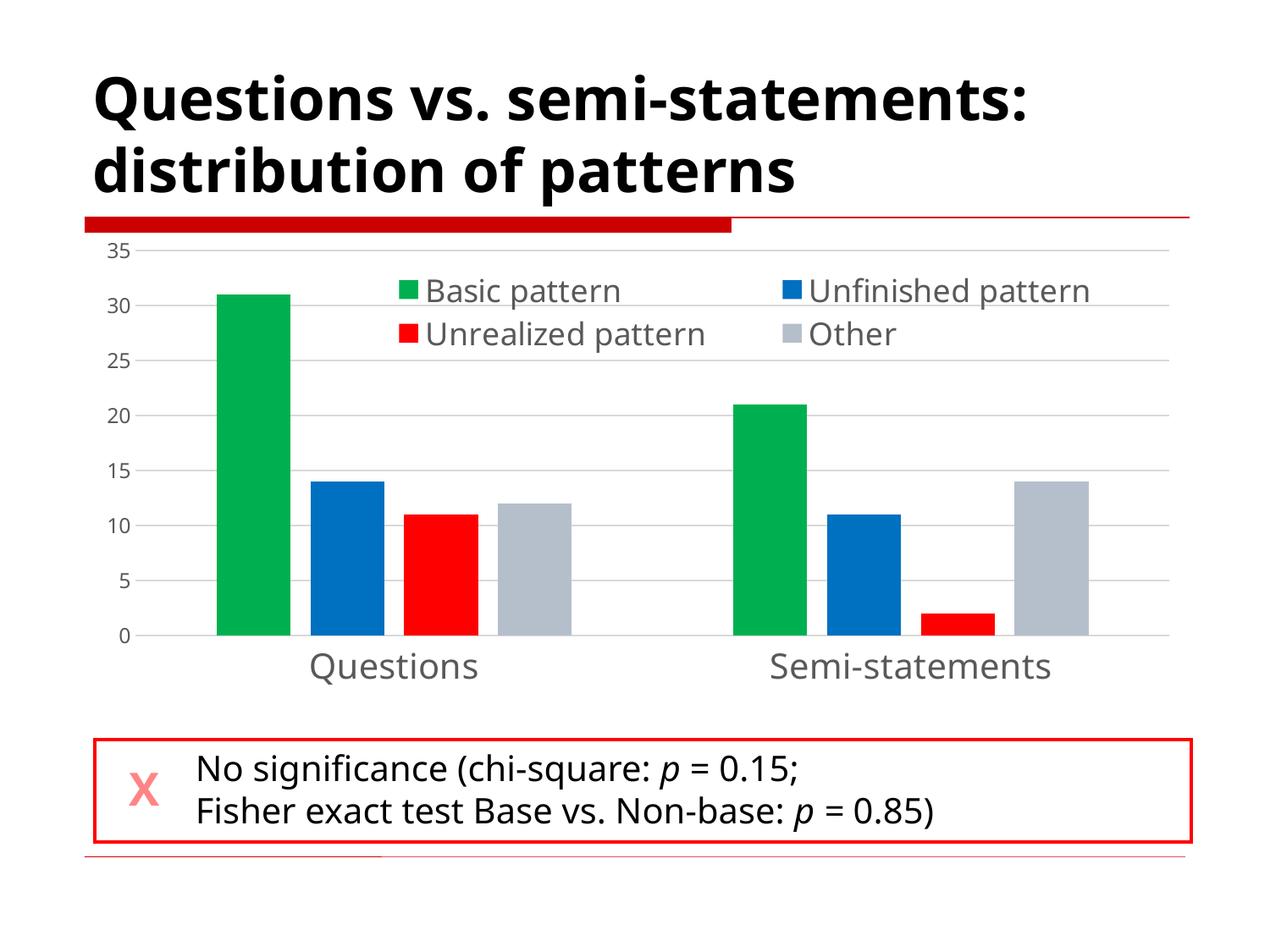
How many series does the legend list? 4 What kind of chart is shown on the slide? bar chart Is the value for Basic pattern in Questions greater or less than 25? greater Which is larger: the Unrealized pattern value for Questions or for Semi-statements? Questions Which is larger: the Basic pattern value for Questions or for Semi-statements? Questions Is the value for Unfinished pattern in Questions greater or less than 10? greater Which pattern has the highest value for Questions? Basic pattern Is the value for Unrealized pattern in Semi-statements greater or less than 5? less What colour represents the Unrealized pattern series in the legend? red How many categories are shown on the x axis? 2 Which pattern has the lowest value for Semi-statements? Unrealized pattern